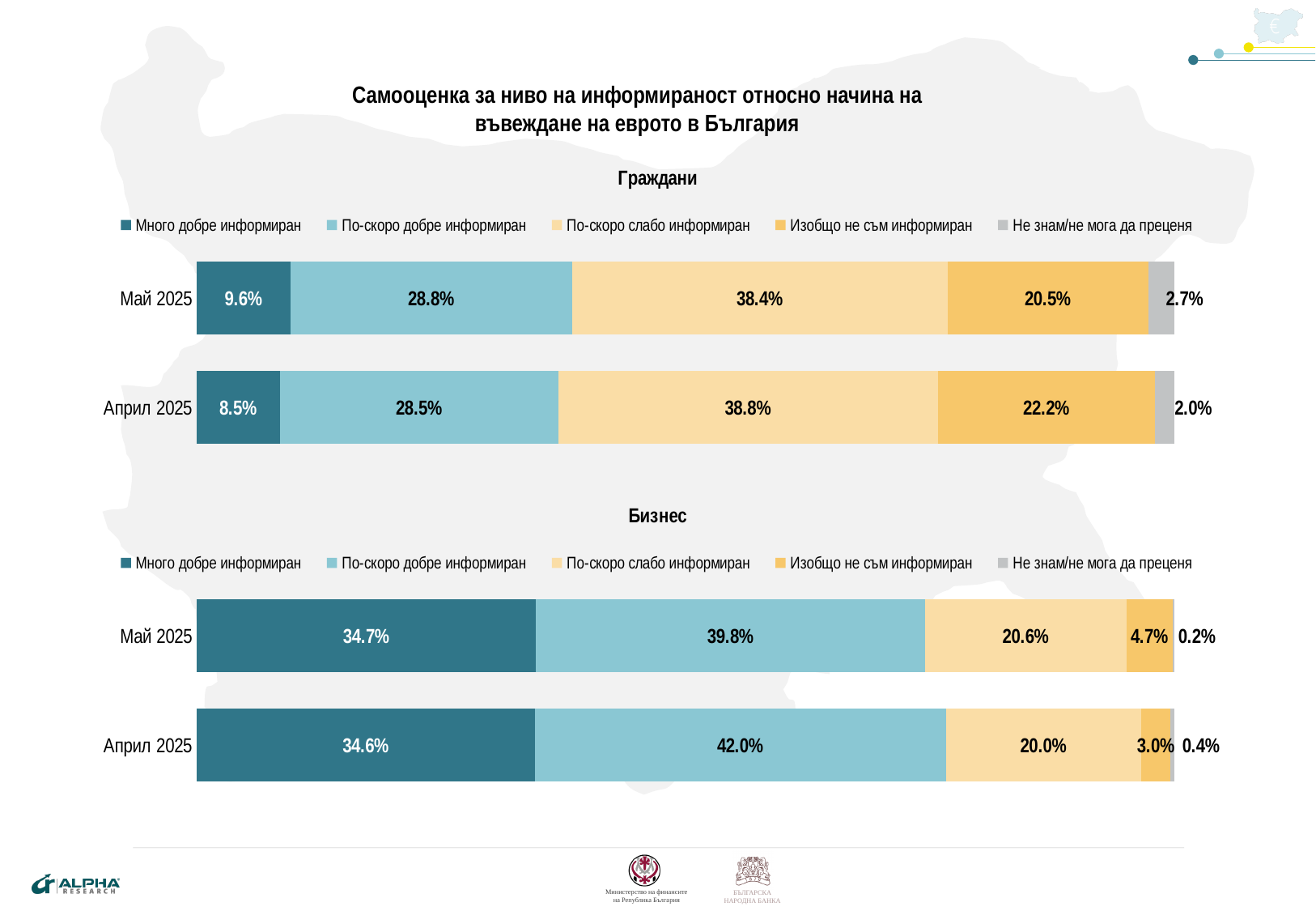
In the Граждани chart, which series has the largest value in Май 2025? По-скоро слабо информиран In the Граждани chart, what is the value for По-скоро слабо информиран in Април 2025? 38.8% In the Бизнес chart, which series has the smallest value in Април 2025? Не знам/не мога да преценя How many bars (time periods) are shown in the Граждани chart? 2 In the Бизнес chart, what is the value for Изобщо не съм информиран in Май 2025? 4.7% In the Бизнес chart, what is the value for По-скоро добре информиран in Април 2025? 42.0% How many series does the legend of the Бизнес chart list? 5 What kind of chart is the Бизнес chart? Stacked bar chart In the Граждани chart, what is the value for Много добре информиран in Май 2025? 9.6% In the Бизнес chart, which is larger: По-скоро добре информиран in Май 2025 or in Април 2025? Април 2025 In the Граждани chart, what is the difference between the Изобщо не съм информиран values for Април 2025 and Май 2025? 1.7% What is the title of the slide's chart? Самооценка за ниво на информираност относно начина на въвеждане на еврото в България